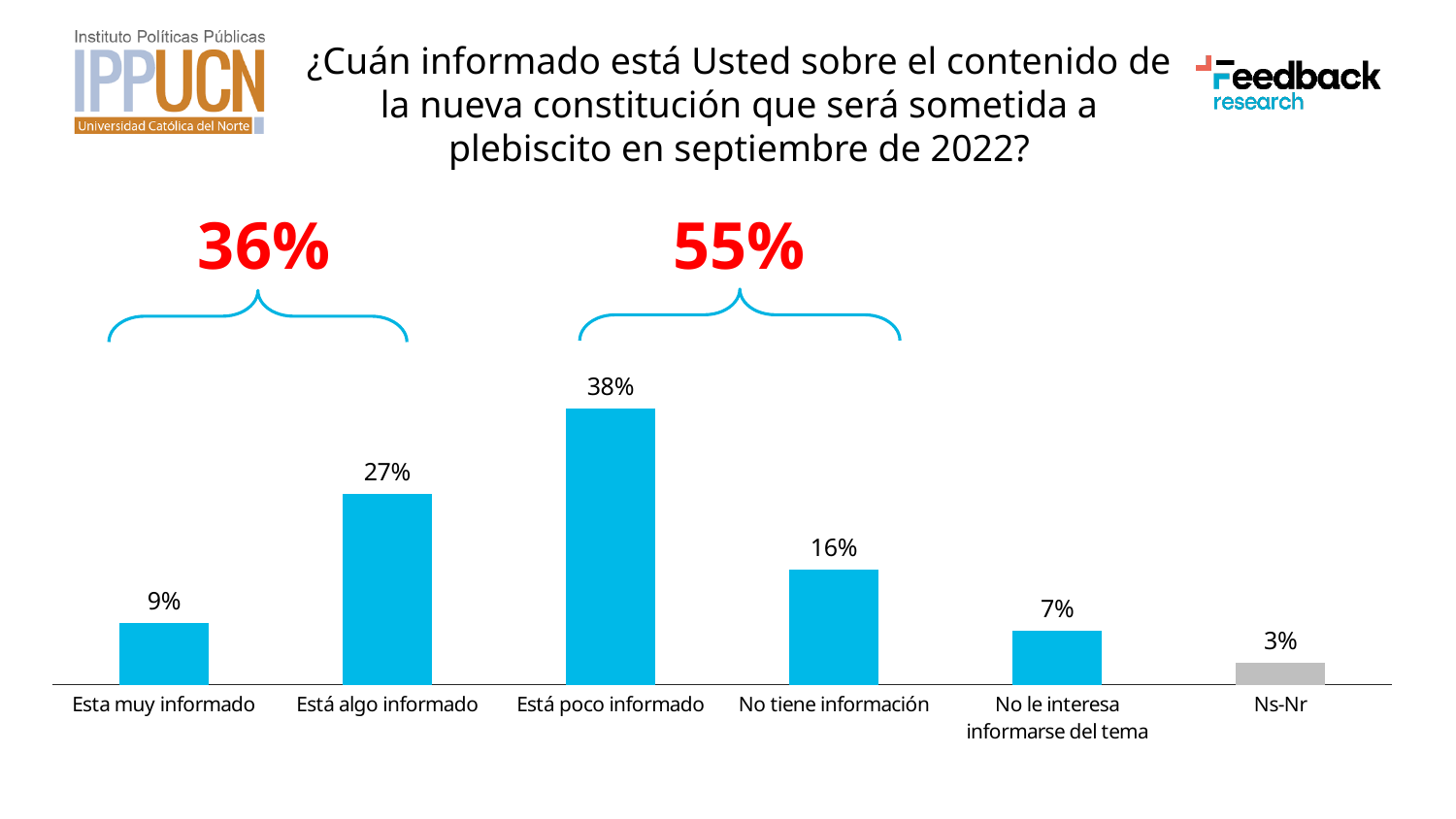
What is the combined percentage shown above the bracket covering "Está poco informado" and "No tiene información"? 55% How many categories are shown on the x axis? 6 What is the combined percentage shown above the bracket covering "Esta muy informado" and "Está algo informado"? 36% What is the difference between "Está algo informado" and "No tiene información"? 11% Which category has the highest value? Está poco informado Which category has the lowest value? Ns-Nr What is the value for "Esta muy informado"? 9% What kind of chart is shown on the slide? Bar chart Which is larger, "Está algo informado" or "No tiene información"? Está algo informado What is the value for "No le interesa informarse del tema"? 7% What is the value for "Está poco informado"? 38% What is the value for "Ns-Nr"? 3%